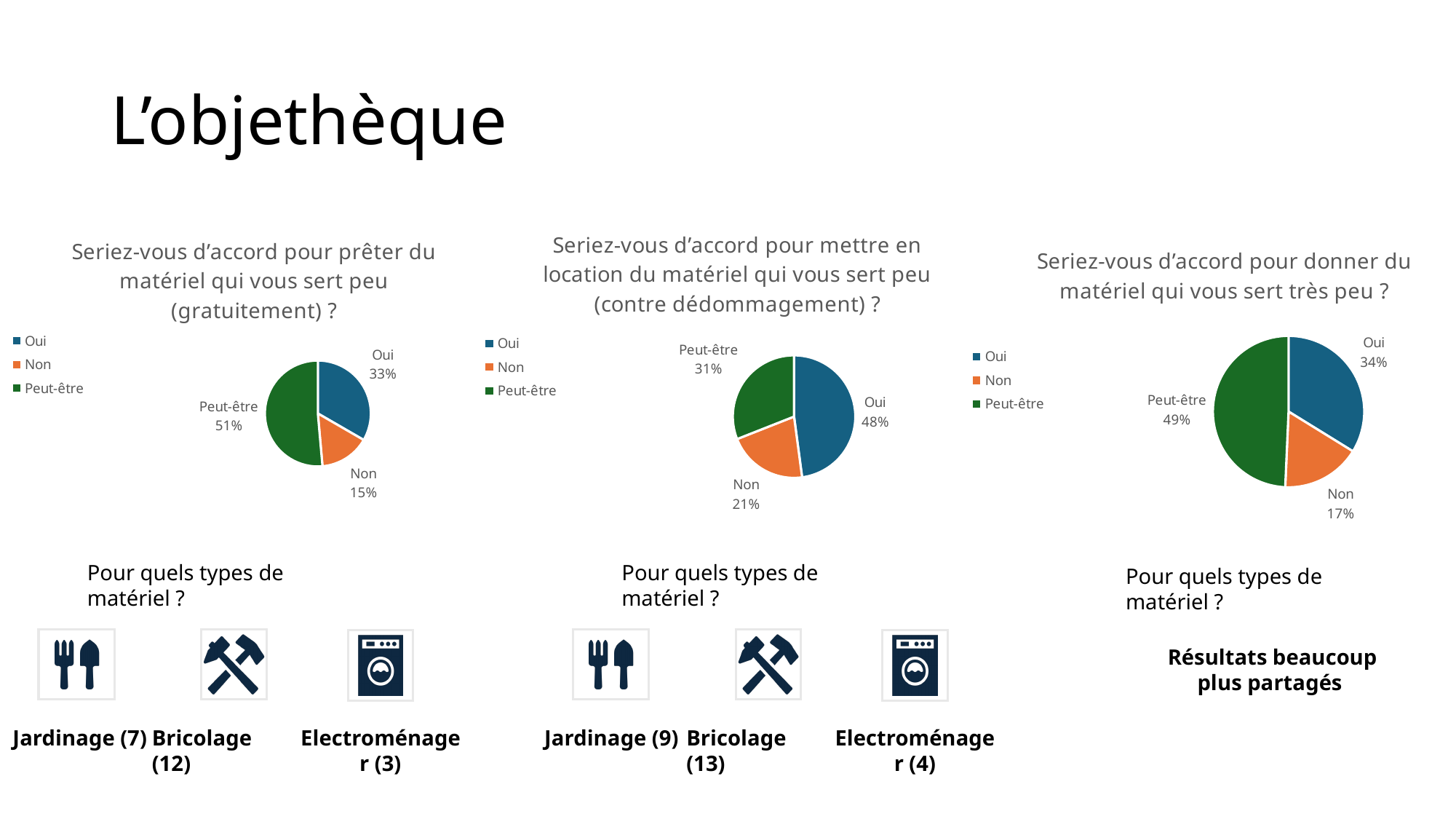
How many entries does the legend of the left pie chart list? 3 In the right pie chart (donner du matériel), what percentage answered Peut-être? 49% In the middle pie chart (mettre en location du matériel), what percentage answered Peut-être? 31% In the middle pie chart (mettre en location du matériel), which is larger, Oui or Peut-être? Oui What type of chart is used for the three survey questions on the slide? Pie chart In the left pie chart (prêter du matériel gratuitement), what percentage answered Oui? 33% In the left pie chart (prêter du matériel gratuitement), what percentage answered Non? 15% In the right pie chart (donner du matériel), what percentage answered Non? 17% In the right pie chart (donner du matériel), what is the difference in percentage points between Oui and Non? 17 In the middle pie chart (mettre en location du matériel), which answer has the smallest share? Non In the left pie chart (prêter du matériel gratuitement), which answer has the largest share? Peut-être In the middle pie chart (mettre en location du matériel), what percentage answered Oui? 48%